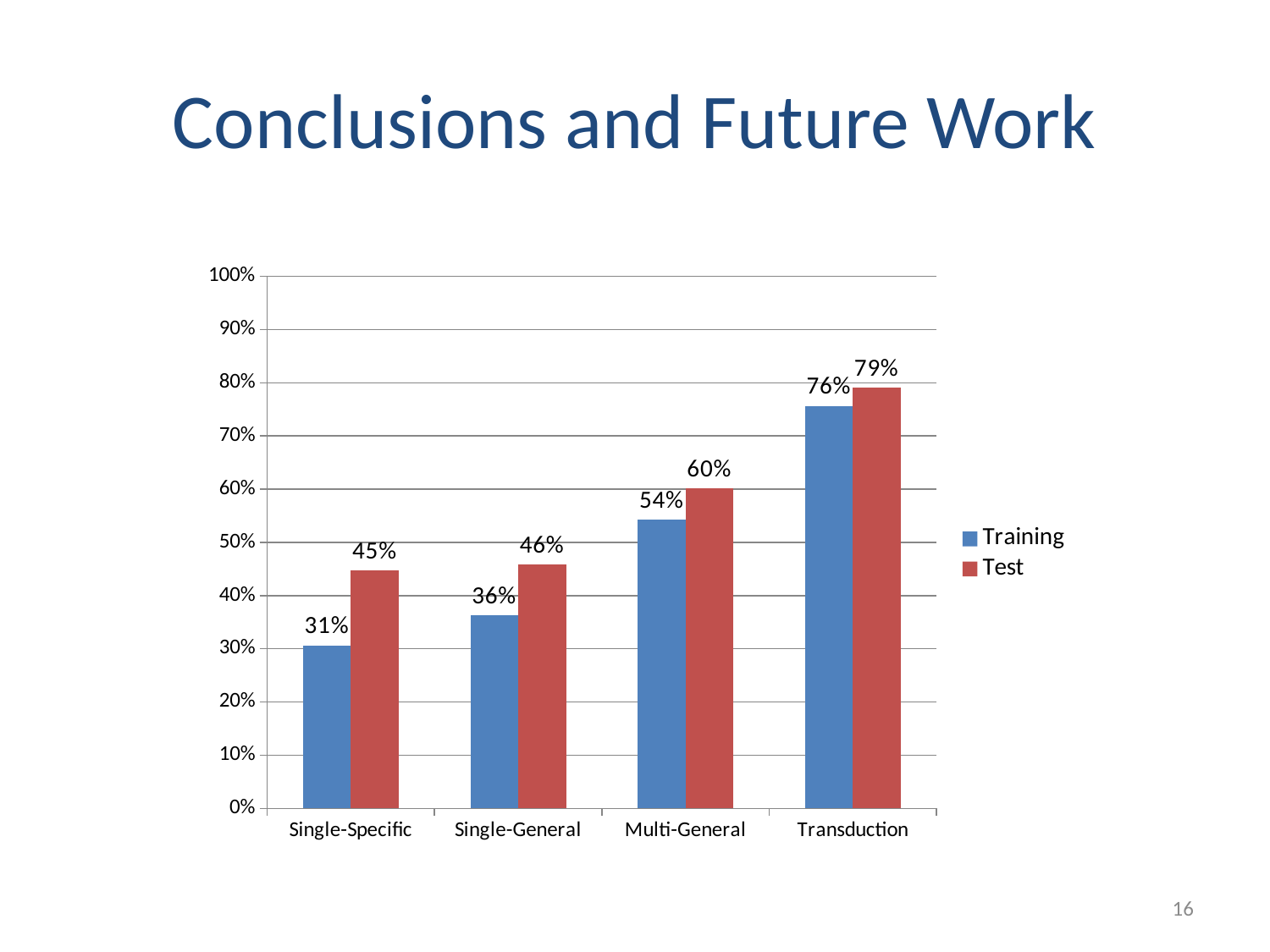
Which category has the lowest Test value? Single-Specific Is the Training value for Multi-General greater or less than 50%? greater How many categories are shown on the x axis? 4 What kind of chart is shown on the slide? bar chart Do the Test values rise or fall from Single-Specific to Transduction? rise Which is larger for Single-General, the Training value or the Test value? Test What is the difference between the Test and Training values for Single-Specific? 14% How many series does the legend list? 2 What is the Test value for Multi-General? 60% What is the Test value for Transduction? 79% What is the Training value for Single-Specific? 31% Which category has the highest Training value? Transduction